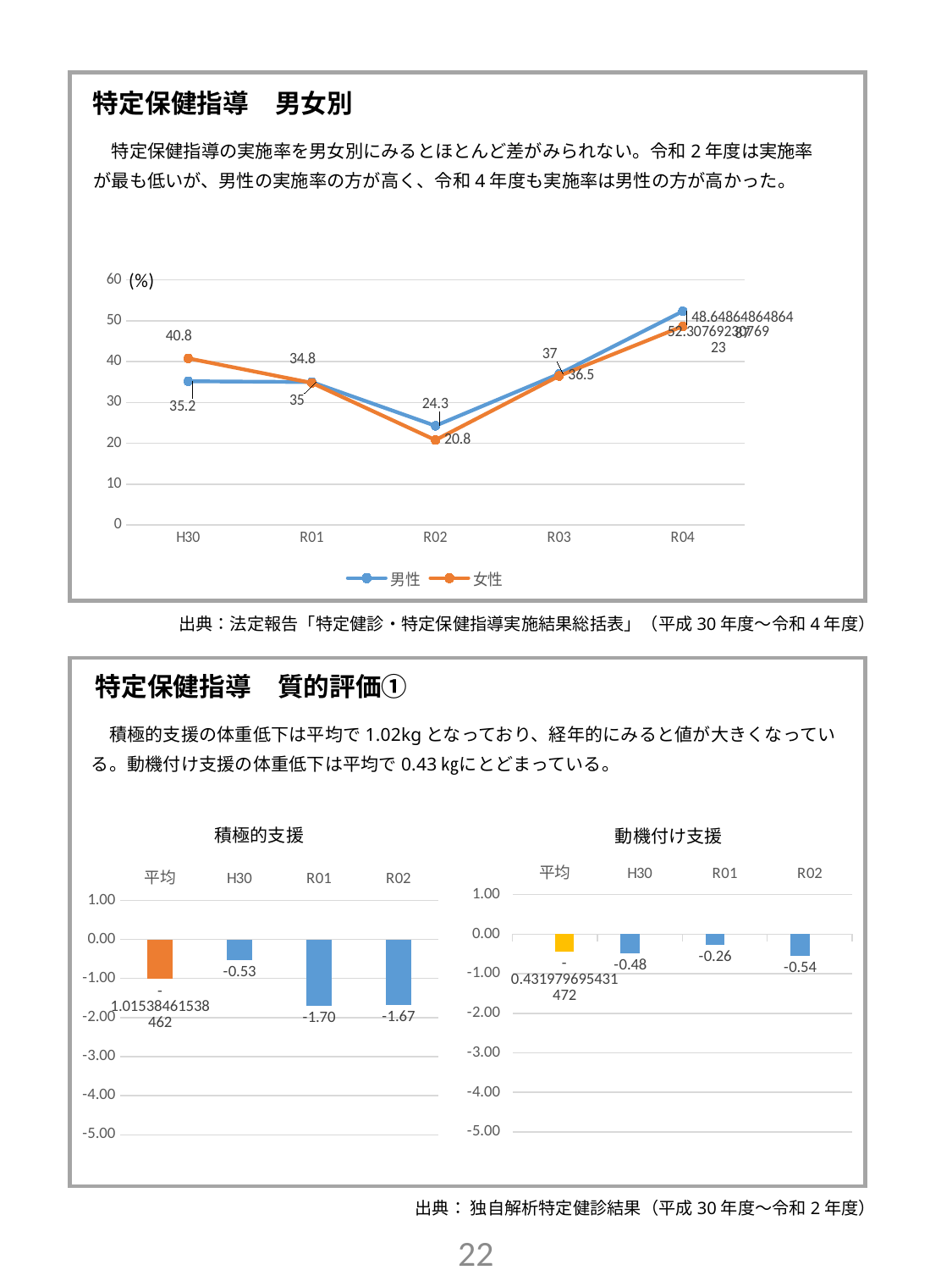
In the line chart titled 特定保健指導 男女別, what is the value for 女性 at R02? 20.8 In the line chart titled 特定保健指導 男女別, which year has the lowest value for 男性? R02 In the bar chart titled 動機付け支援, how many categories are shown on the x axis? 4 In the line chart titled 特定保健指導 男女別, is the value for 男性 at R04 greater or less than 50? greater In the bar chart titled 動機付け支援, what is the value for R02? -0.54 In the line chart titled 特定保健指導 男女別, what is the value for 男性 at H30? 35.2 In the line chart titled 特定保健指導 男女別, what is the value for 女性 at H30? 40.8 In the line chart titled 特定保健指導 男女別, what is the difference between 男性 and 女性 at R02? 3.5 In the bar chart titled 積極的支援, what is the value for H30? -0.53 In the line chart titled 特定保健指導 男女別, how many series does the legend list? 2 In the line chart titled 特定保健指導 男女別, which is larger at H30, 男性 or 女性? 女性 In the bar chart titled 積極的支援, what is the value for R01? -1.70